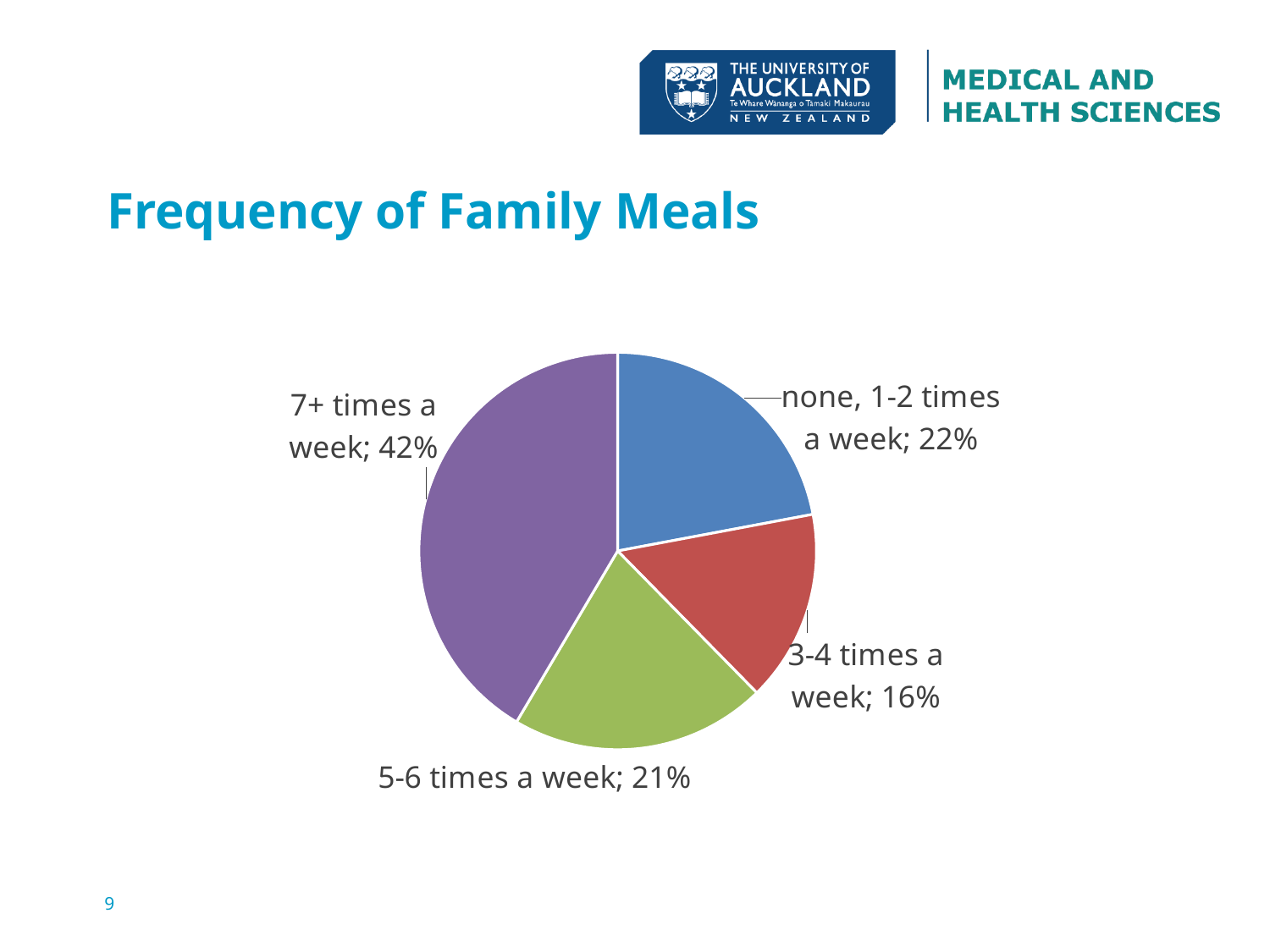
What kind of chart is shown on the slide? pie chart How many slices does the pie chart have? 4 What share of the pie is labelled 'none, 1-2 times a week'? 22% Which category has the largest slice of the pie? 7+ times a week Which category has the smallest slice of the pie? 3-4 times a week What share of the pie is labelled '3-4 times a week'? 16% What share of the pie is labelled '5-6 times a week'? 21% Which is larger, the '5-6 times a week' slice or the '3-4 times a week' slice? 5-6 times a week What is the title of the chart? Frequency of Family Meals What is the difference in percentage points between the '7+ times a week' slice and the '3-4 times a week' slice? 26 percentage points What colour is the '7+ times a week' slice? purple